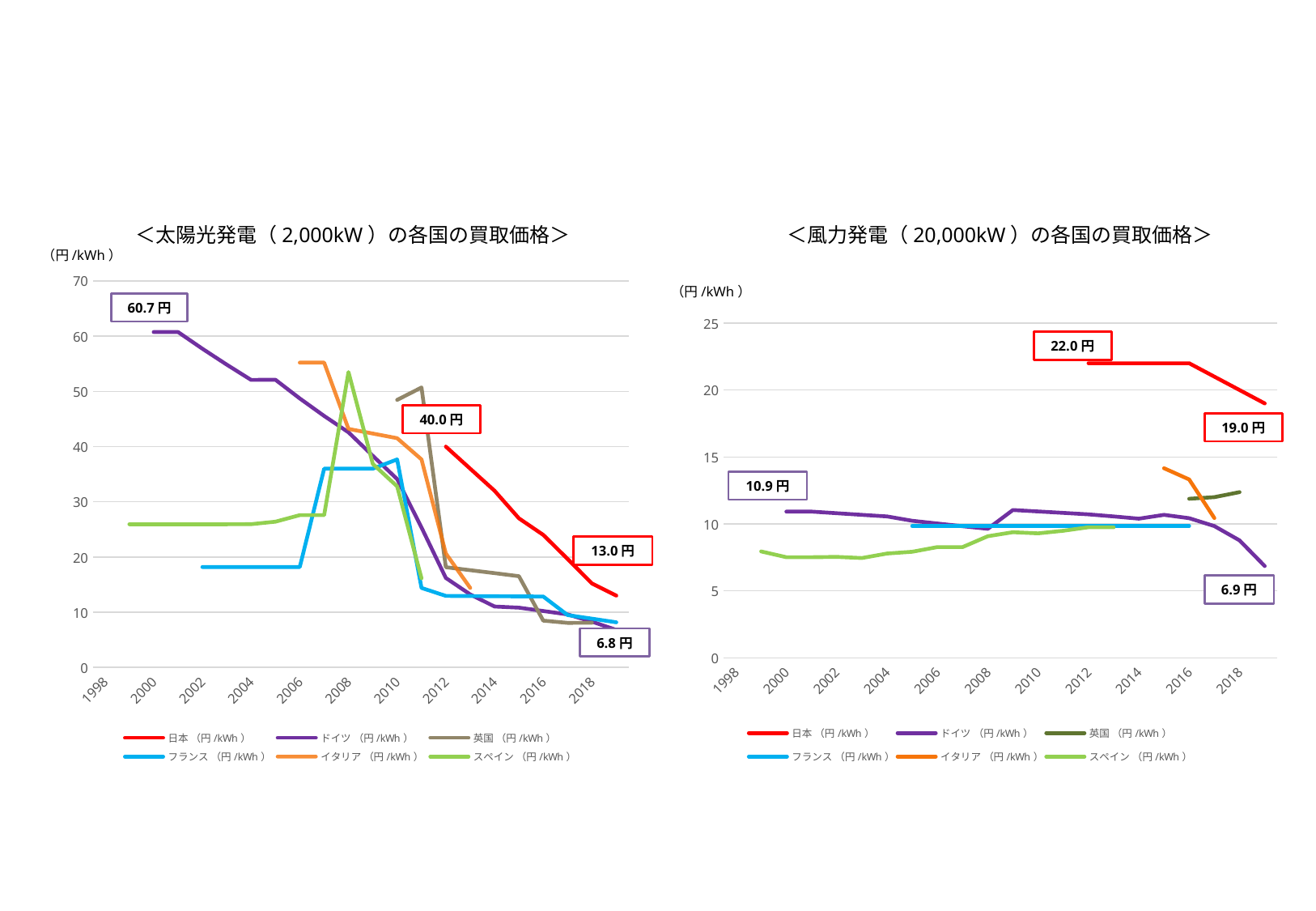
In the left chart (太陽光発電), what is the labelled value for 日本 in 2012? 40.0円 In the right chart (風力発電), what is the difference between the labelled 日本 values of 22.0円 and 19.0円? 3.0円 In the left chart (太陽光発電), is the value for スペイン in 2008 greater or less than 50? greater In the right chart (風力発電), what is the labelled value for 日本 in 2012? 22.0円 How many series does the legend of the right chart, ＜風力発電（20,000kW）の各国の買取価格＞, list? 6 What kind of chart is the left chart, ＜太陽光発電（2,000kW）の各国の買取価格＞? line chart In the left chart (太陽光発電), what is the difference between the labelled ドイツ values of 60.7円 and 6.8円? 53.9円 In the left chart (太陽光発電), does the ドイツ line rise or fall from 2000 to 2019? fall In the right chart (風力発電), which is larger in 2019: the labelled value for 日本 or for ドイツ? 日本 In the left chart (太陽光発電), what is the labelled value for 日本 at the end of the series in 2019? 13.0円 In the left chart (太陽光発電), what is the labelled value for ドイツ in 2000? 60.7円 In the right chart (風力発電), what is the labelled value for ドイツ in 2019? 6.9円